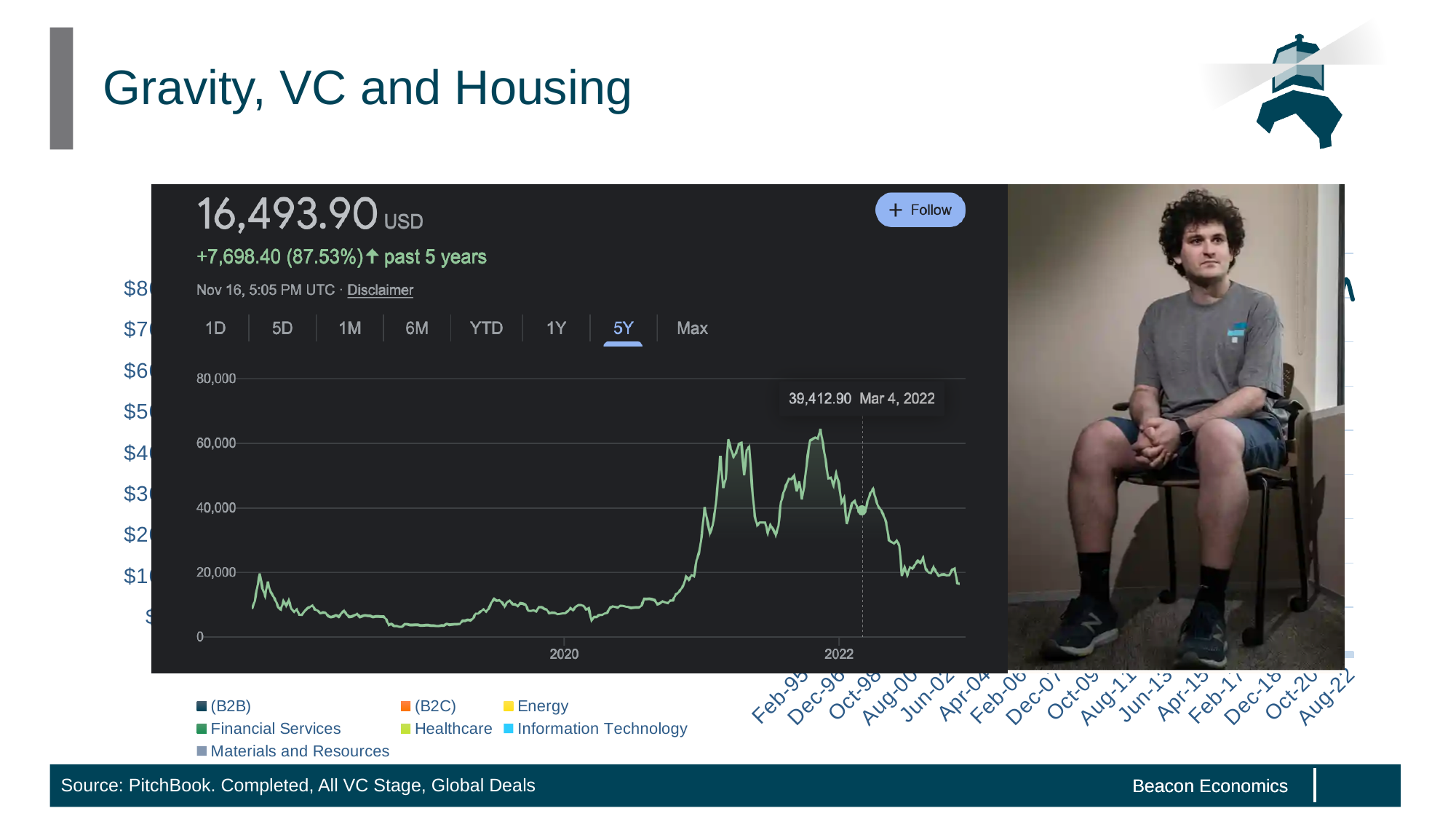
On the dark-background price chart, what is the highest value labelled on the vertical axis? 80,000 On the dark-background price chart, what is the current value shown at the top left? 16,493.90 USD On the dark-background price chart, what value does the tooltip show for Mar 4, 2022? 39,412.90 What is the date and time stamp shown on the dark-background price chart? Nov 16, 5:05 PM UTC On the dark-background price chart, does the line rise or fall from its Mar 4, 2022 point to the right end of the chart? fall On the dark-background price chart, which time-range button is selected? 5Y On the dark-background price chart, is the highest peak of the line greater or less than 60,000? greater What kind of chart is the dark-background price chart in the centre of the slide? line chart How many series does the legend of the underlying slide chart (below the screenshot) list? 7 On the dark-background price chart, is the value at the far right end of the line greater or less than 20,000? less On the dark-background price chart, what change over the past 5 years is shown? +7,698.40 (87.53%) On the dark-background price chart, is the value at the start of the line (far left) greater or less than 40,000? less